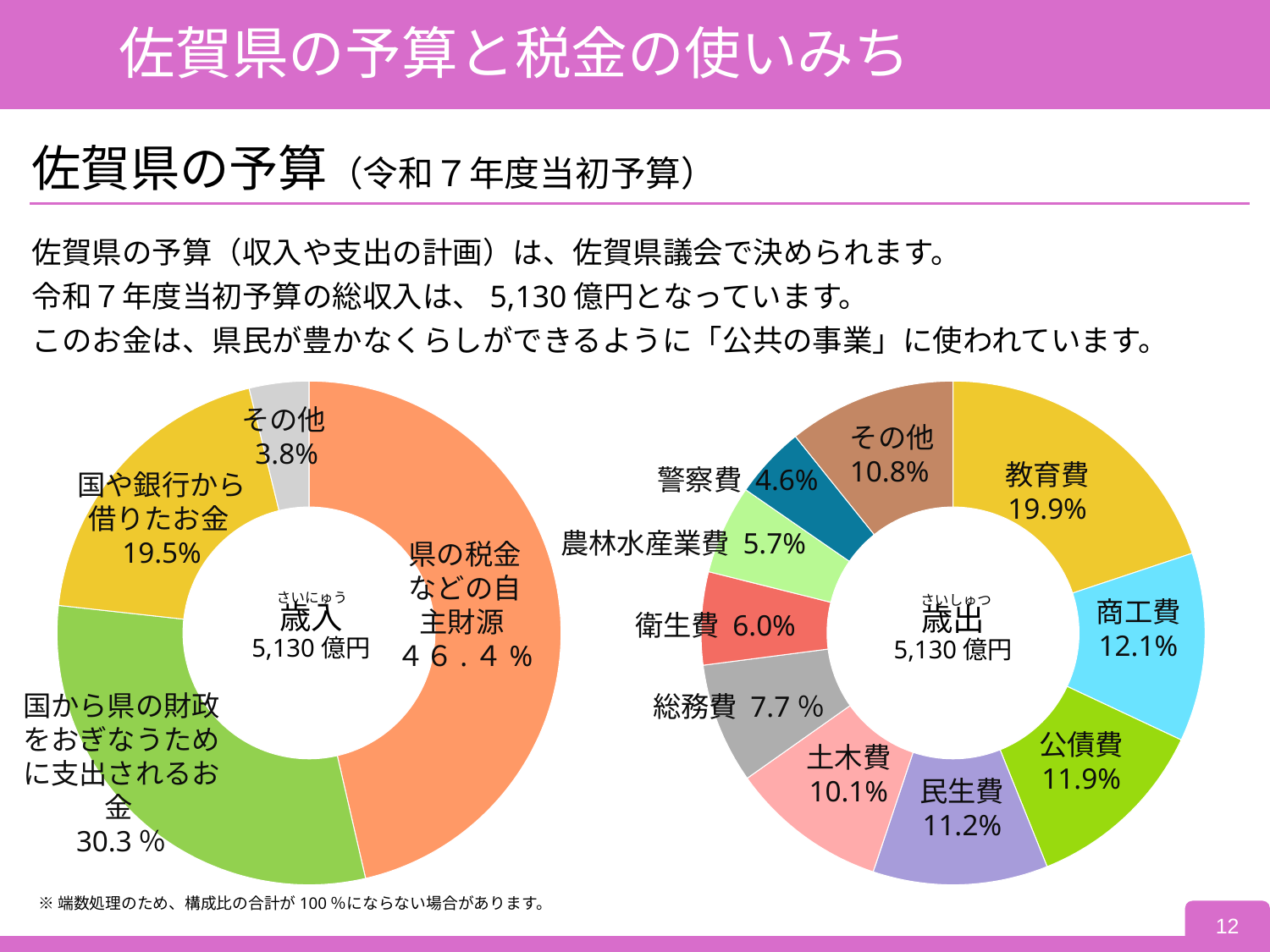
In the 歳入 (revenue) chart, what share is 県の税金などの自主財源? 46.4% In the 歳出 chart, which category has the smallest share? 警察費 In the 歳出 (expenditure) chart, what share is 教育費? 19.9% In the 歳入 chart, which category has the smallest share? その他 In the 歳入 chart, what share is 国や銀行から借りたお金? 19.5% In the 歳出 chart, how many categories are shown? 10 In the 歳出 chart, what share is 農林水産業費? 5.7% In the 歳出 chart, which category has the largest share? 教育費 What type of chart is used for 歳入 and 歳出 on this slide? Donut (pie) chart In the 歳入 chart, what is the difference between 県の税金などの自主財源 and 国から県の財政をおぎなうために支出されるお金? 16.1 percentage points In the 歳出 chart, which is larger, 商工費 or 民生費? 商工費 In the 歳入 chart, how many categories are shown? 4